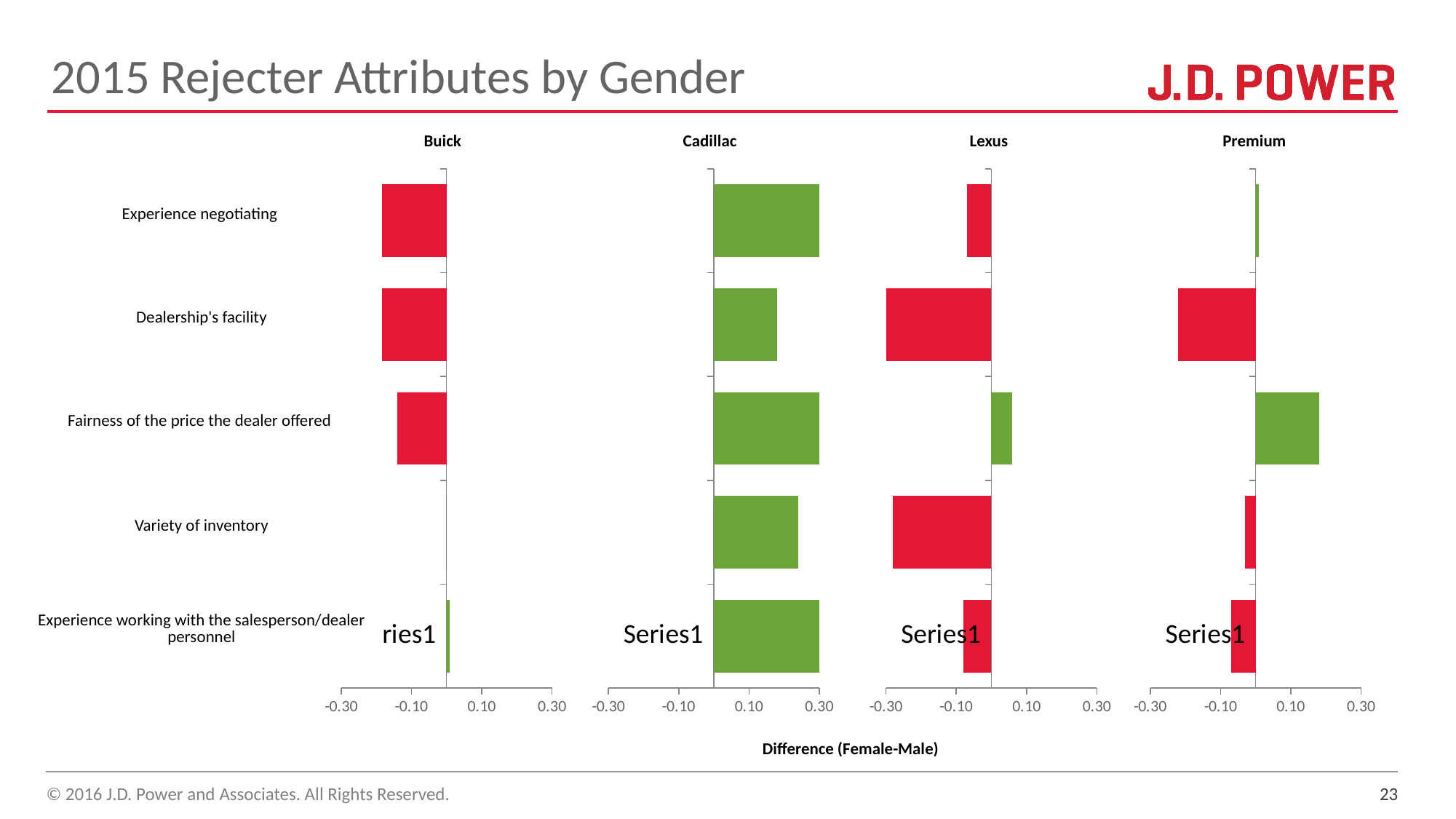
In the Premium chart, which attribute has the highest value? Fairness of the price the dealer offered In the Cadillac chart, which is larger: the value for Dealership's facility or the value for Fairness of the price the dealer offered? Fairness of the price the dealer offered In the Buick chart, is the value for Experience negotiating greater or less than -0.10? less In the Lexus chart, which is larger: the value for Experience negotiating or the value for Dealership's facility? Experience negotiating In the Premium chart, is the value for Fairness of the price the dealer offered greater or less than 0.10? greater How many attribute categories are plotted in each chart? 5 What kind of chart is used for the Buick panel? bar chart In the Lexus chart, is the value for Dealership's facility greater or less than -0.10? less What is the label of the shared horizontal axis beneath the charts? Difference (Female-Male) In the Premium chart, which attribute has the lowest value? Dealership's facility